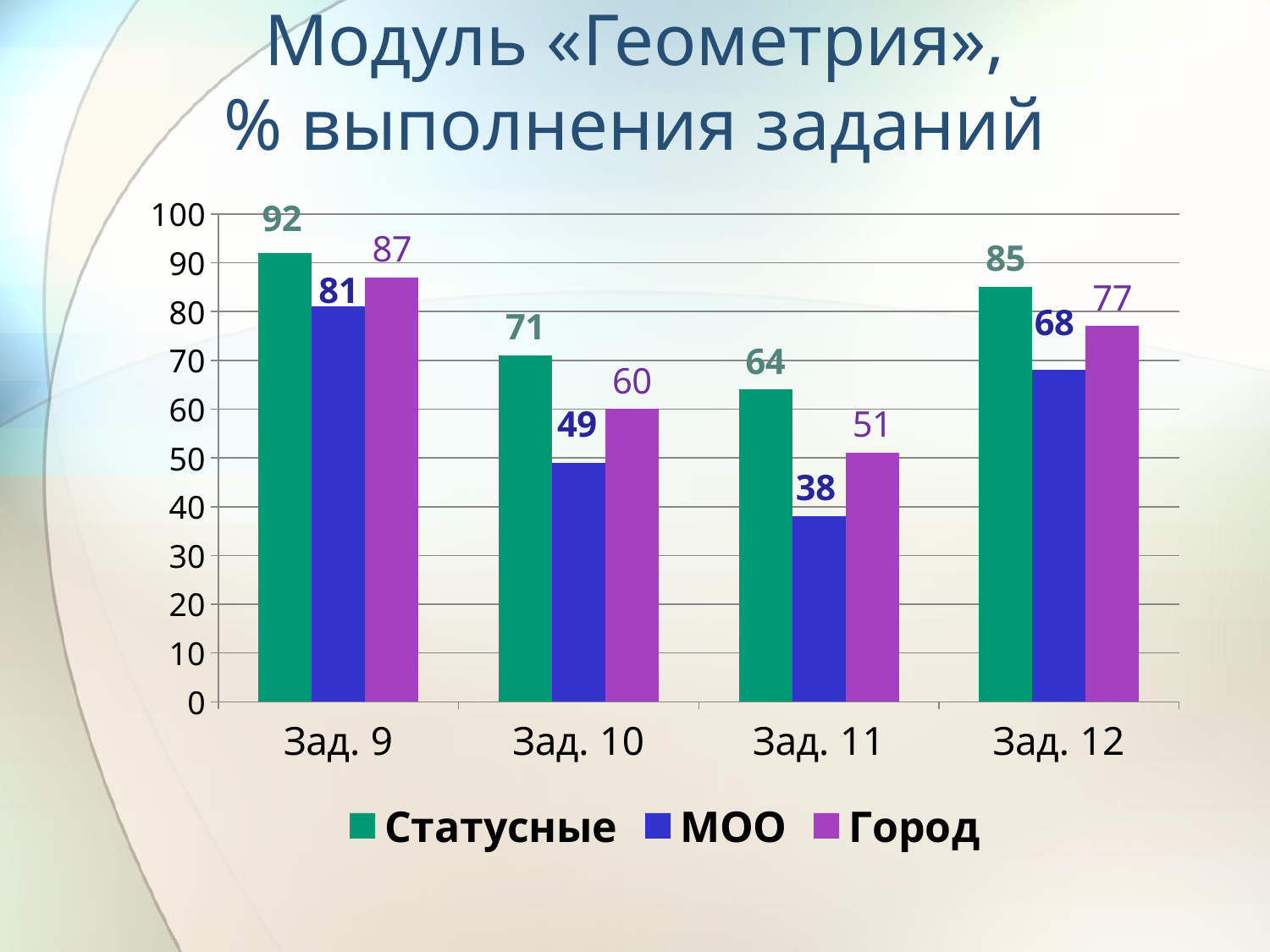
Which task has the highest value for the Статусные series? Зад. 9 What is the difference between the Статусные and МОО values on Зад. 10? 22 What is the value for Город on Зад. 12? 77 What is the value for Статусные on Зад. 9? 92 Which task has the lowest value for the МОО series? Зад. 11 What kind of chart is shown on the slide? bar chart How many tasks are shown on the x axis? 4 Which series is shown in purple in the legend? Город What is the value for МОО on Зад. 11? 38 Is the value for Город on Зад. 11 greater or less than 60? less Which is larger on Зад. 12: the МОО value or the Город value? Город How many series does the legend list? 3